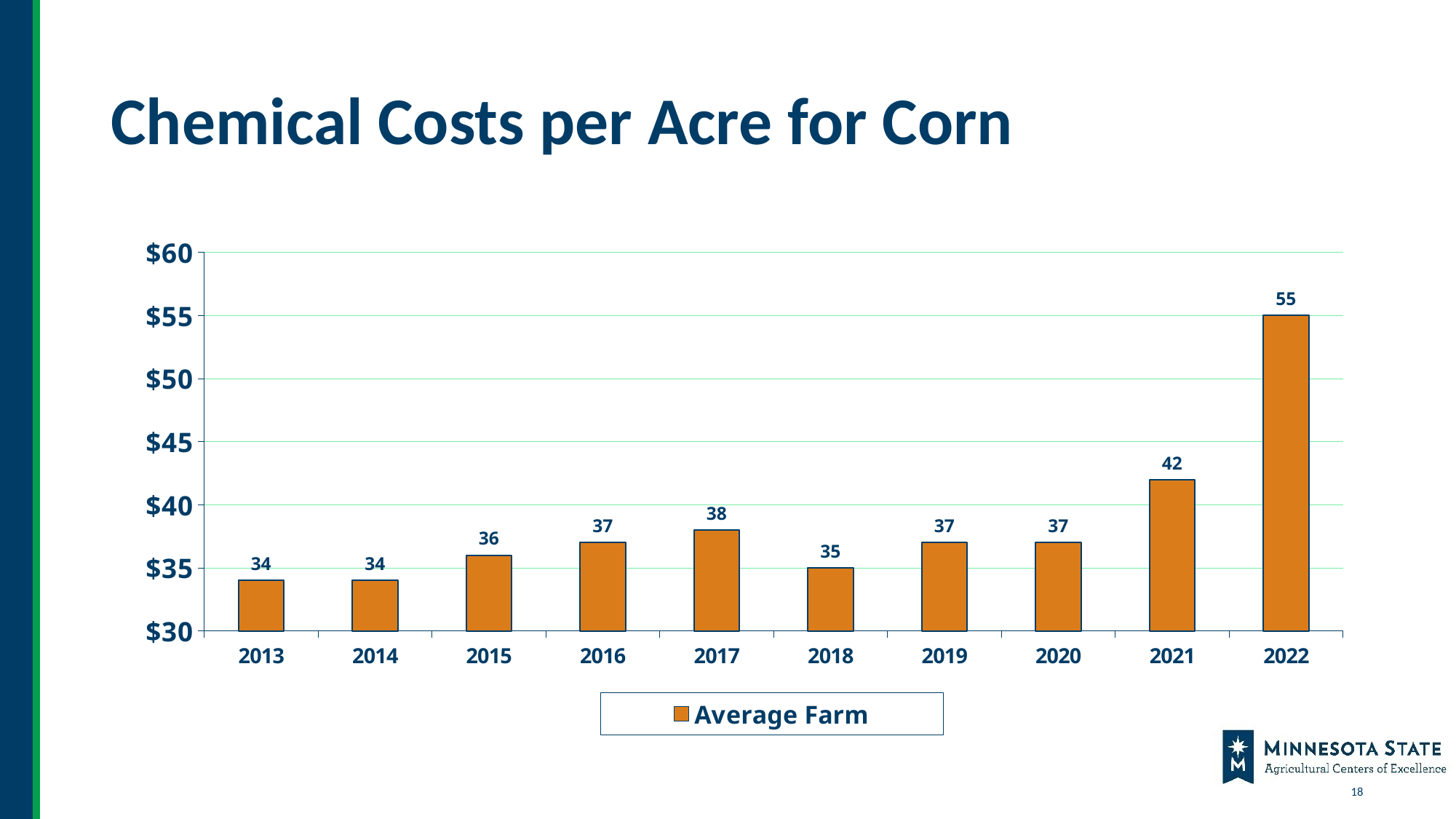
What kind of chart is shown on the slide? bar chart Is the value for 2022 greater or less than $50? greater What is the difference between the 2017 value and the 2013 value? 4 Which is larger, the value for 2021 or the value for 2020? 2021 What is the name of the series in the legend? Average Farm What is the value shown for 2018? 35 How many series does the legend list? 1 How many years are shown on the x axis? 10 What is the value shown for 2017? 38 Which year has the highest chemical cost per acre? 2022 What is the chemical cost per acre for corn in 2022? 55 What is the difference between the 2022 value and the 2021 value? 13